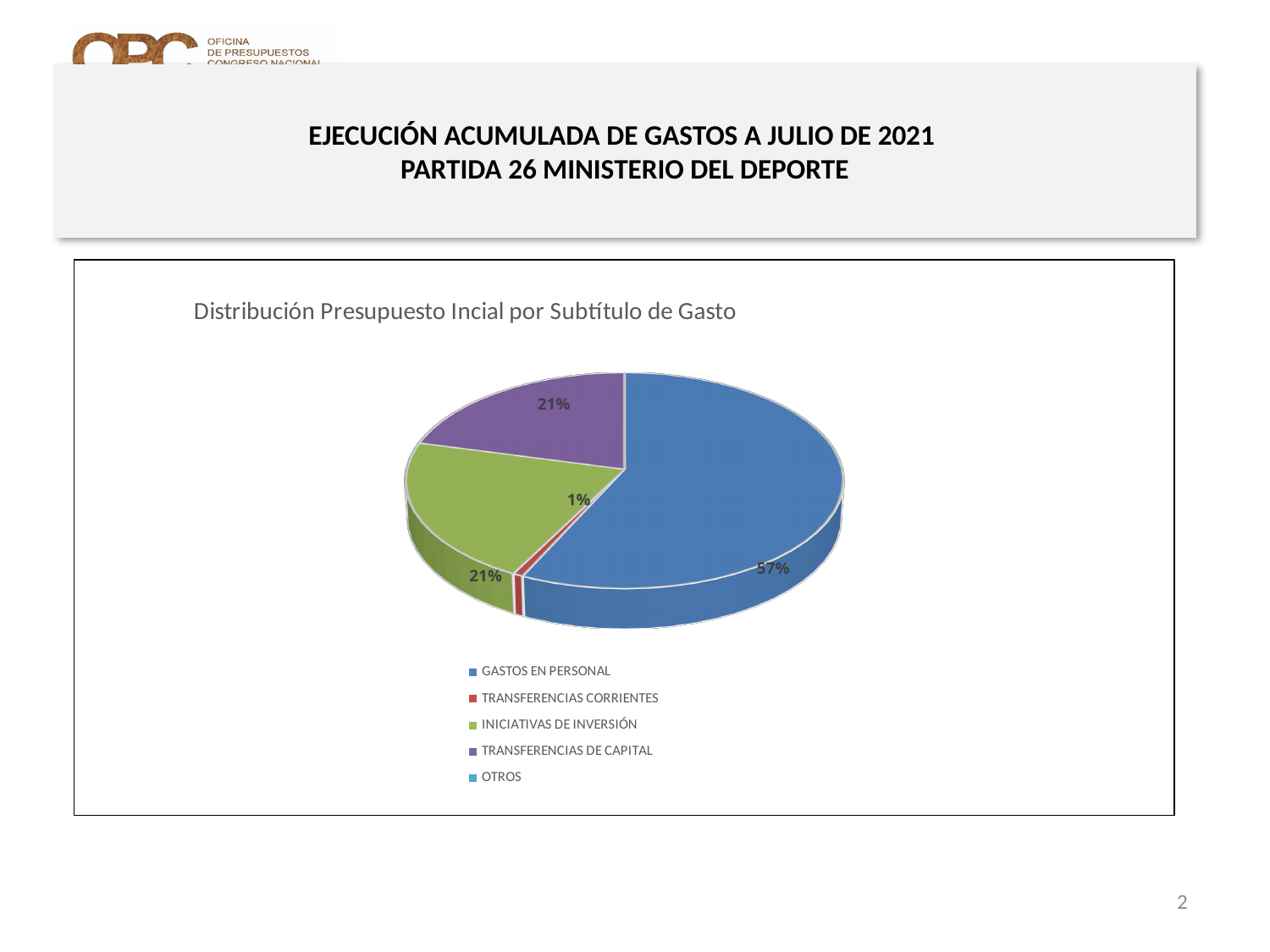
Which labelled slice has the smallest share of the pie? TRANSFERENCIAS CORRIENTES What kind of chart is shown on the slide? pie chart What percentage of the pie does GASTOS EN PERSONAL represent? 57% What percentage of the pie does INICIATIVAS DE INVERSIÓN represent? 21% How many percentage points larger is the GASTOS EN PERSONAL share than the INICIATIVAS DE INVERSIÓN share? 36 What percentage of the pie does TRANSFERENCIAS DE CAPITAL represent? 21% What is the title of the chart? Distribución Presupuesto Incial por Subtítulo de Gasto Which category has the largest share of the pie? GASTOS EN PERSONAL What percentage of the pie does TRANSFERENCIAS CORRIENTES represent? 1% Which is larger, the share for GASTOS EN PERSONAL or the share for TRANSFERENCIAS DE CAPITAL? GASTOS EN PERSONAL Which legend entry is shown in purple? TRANSFERENCIAS DE CAPITAL How many entries does the legend list? 5